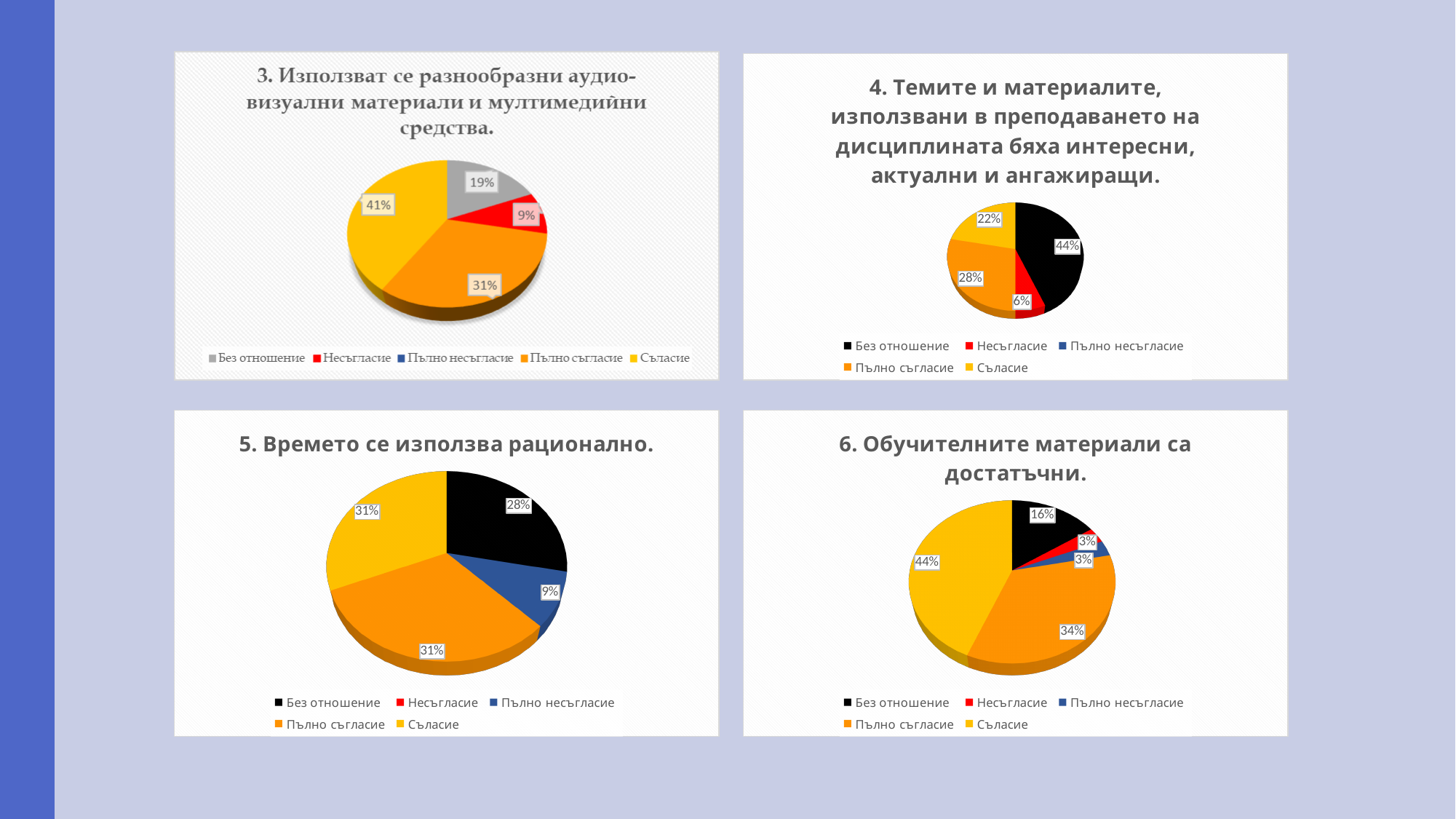
In the chart titled "5. Времето се използва рационално.", which is larger, "Без отношение" or "Пълно съгласие"? Пълно съгласие In the chart titled "4. Темите и материалите, използвани в преподаването на дисциплината бяха интересни, актуални и ангажиращи.", what is the difference between the shares of "Пълно съгласие" and "Съгласие"? 6% In the chart titled "4. Темите и материалите, използвани в преподаването на дисциплината бяха интересни, актуални и ангажиращи.", which category has the largest slice? Без отношение How many entries does the legend list in the chart titled "6. Обучителните материали са достатъчни."? 5 In the chart titled "6. Обучителните материали са достатъчни.", what is the difference between the shares of "Съгласие" and "Пълно съгласие"? 10% In the chart titled "6. Обучителните материали са достатъчни.", how many slices are labelled with a percentage? 5 In the chart titled "3. Използват се разнообразни аудио-визуални материали и мултимедийни средства.", what share does "Без отношение" have? 19% In the chart titled "4. Темите и материалите, използвани в преподаването на дисциплината бяха интересни, актуални и ангажиращи.", what share does "Несъгласие" have? 6% In the chart titled "3. Използват се разнообразни аудио-визуални материали и мултимедийни средства.", what share does "Съгласие" have? 41% What type of chart is used in the chart titled "5. Времето се използва рационално."? Pie chart In the chart titled "6. Обучителните материали са достатъчни.", what share does "Съгласие" have? 44% In the chart titled "5. Времето се използва рационално.", what share does "Пълно несъгласие" have? 9%